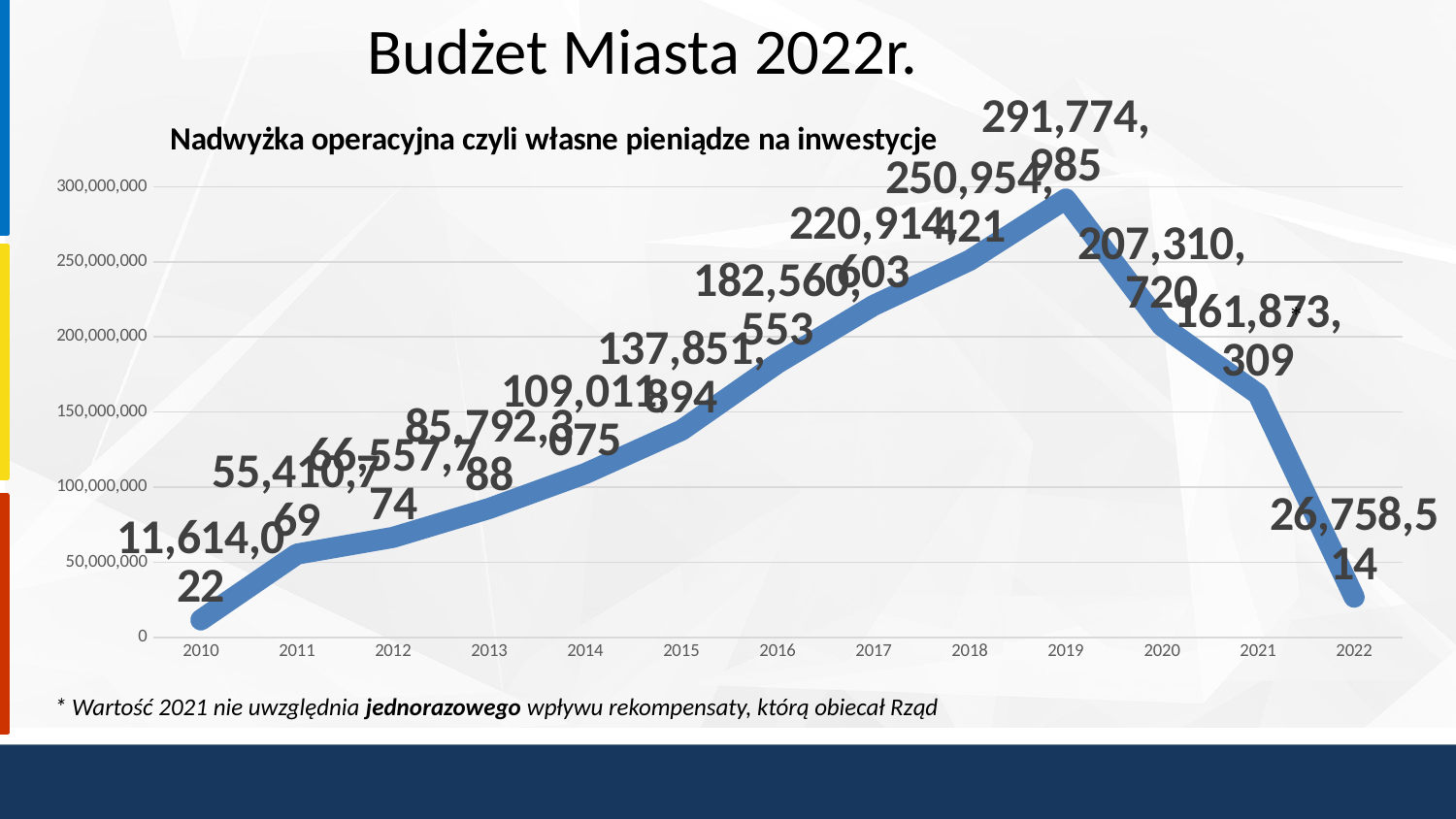
What is the value for 2010? 11,614,022 What is the difference between the values for 2019 and 2022? 265,016,471 What is the title of the chart? Nadwyżka operacyjna czyli własne pieniądze na inwestycje What is the value for 2021? 161,873,309 Which year has the lowest value on the chart? 2010 Is the value for 2015 greater or less than 150,000,000? less What is the value for 2022? 26,758,514 What type of chart is shown on the slide? Line chart Which year has the highest value on the chart? 2019 How many years (data points) are plotted on the chart? 13 Which year has the larger value, 2020 or 2021? 2020 What is the value for 2019? 291,774,985